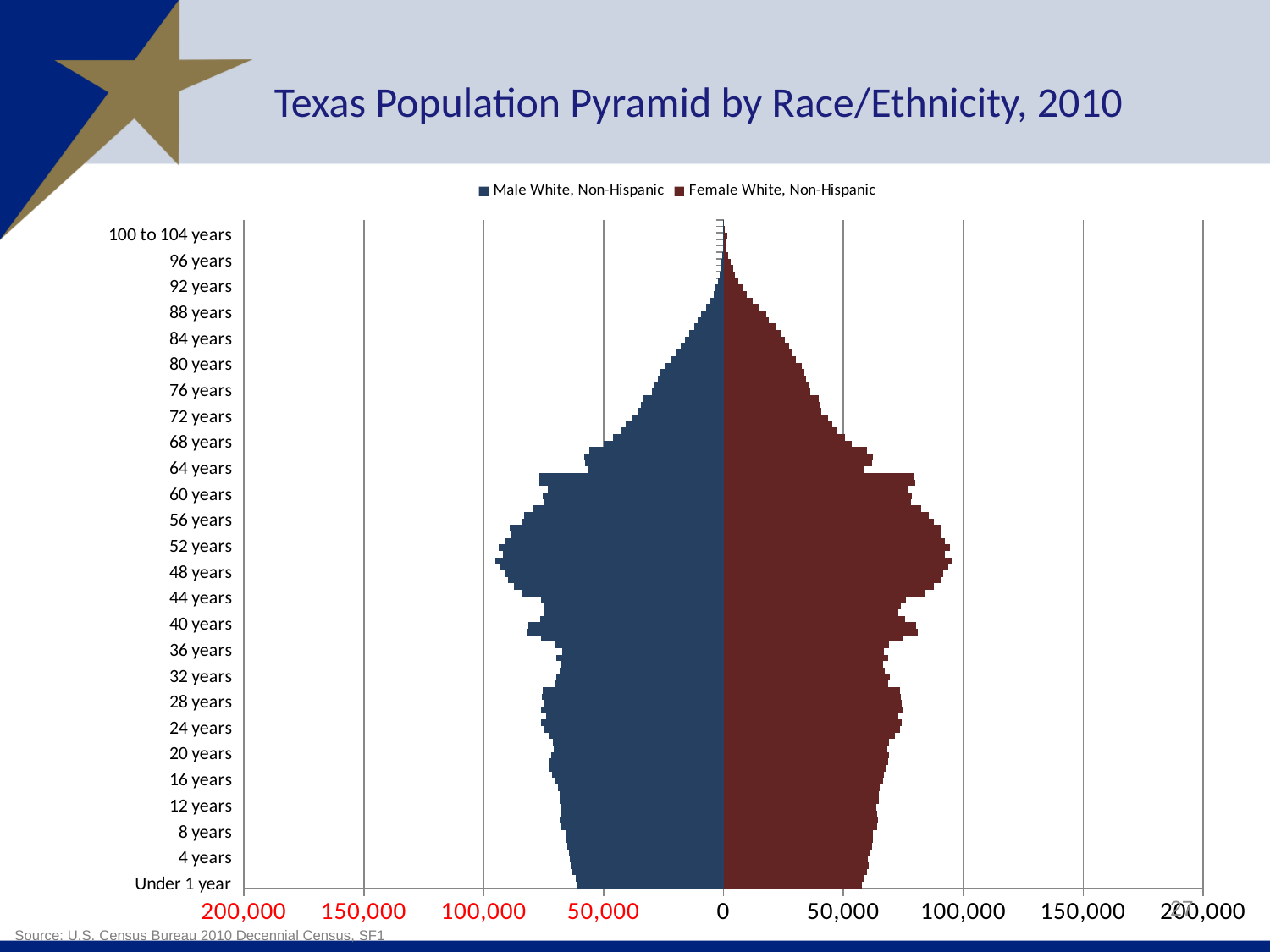
Which is larger for Male White, Non-Hispanic: the value at 48 years or the value at 88 years? 48 years How many series does the legend list? 2 What kind of chart is shown on the slide? bar chart Is the value for Female White, Non-Hispanic at 48 years greater or less than 50,000? greater Is the value for Male White, Non-Hispanic at 48 years greater or less than 50,000? greater Which is larger for Female White, Non-Hispanic: the value at 52 years or the value at 80 years? 52 years Is the value for Male White, Non-Hispanic at 88 years greater or less than 50,000? less Which series is shown in dark red? Female White, Non-Hispanic What is the title of the chart? Texas Population Pyramid by Race/Ethnicity, 2010